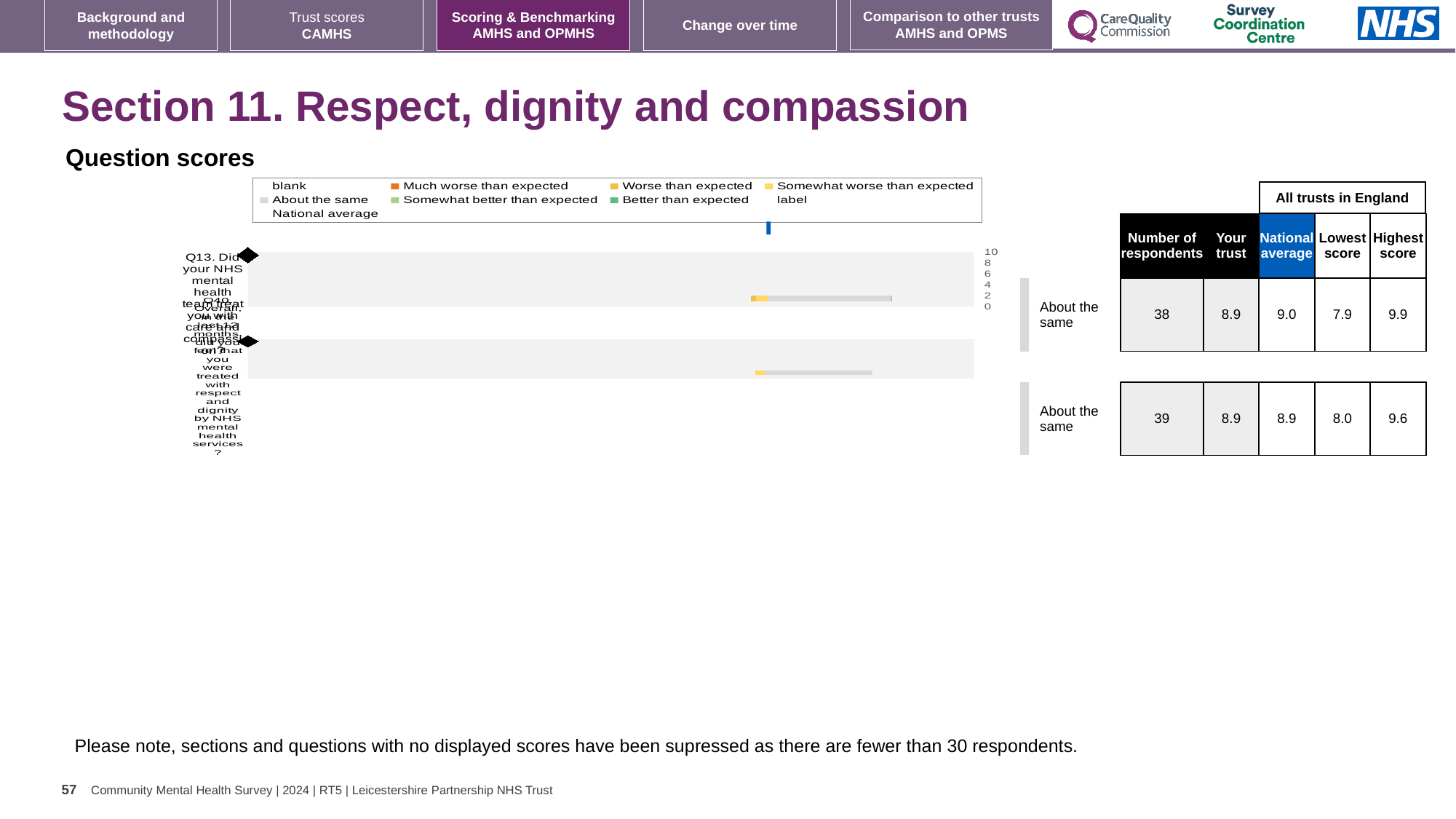
What kind of chart is shown under 'Question scores'? bar chart In the table beside the chart, what is the lowest score for the bottom row? 8.0 In the table beside the chart, what is the national average for the bottom row? 8.9 In the table beside the chart, what is the difference between the highest score and the lowest score for the top row? 2.0 In the table beside the chart, what is the number of respondents for the bottom row? 39 How many question rows are plotted in the chart? 2 In the table beside the chart, what is the 'Your trust' score for the top row? 8.9 In the table beside the chart, what is the highest score for the top row? 9.9 In the table beside the chart, what is the number of respondents for the top row? 38 What colour represents 'Much worse than expected' in the chart legend? orange What benchmark category is shown next to both rows of the chart? About the same What colour represents 'Better than expected' in the chart legend? green